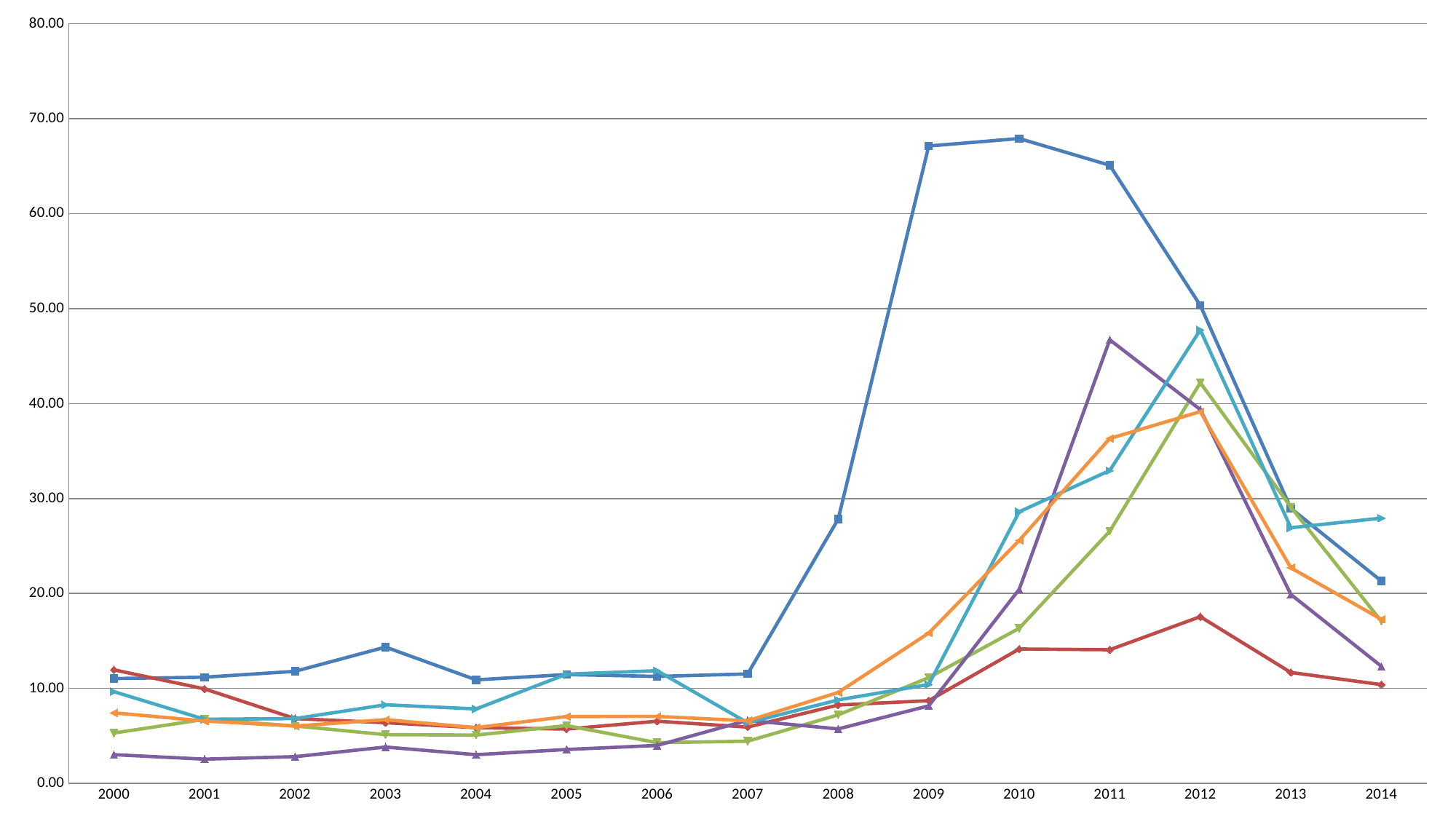
Is the value of the purple line in 2011 greater or less than 40? greater What kind of chart is shown on the slide? line chart Is the value of the red line in 2012 greater or less than 20? less In which year does the purple line reach its highest value? 2011 How many years are shown along the x axis of the chart? 15 Is the value of the blue line in 2010 greater or less than 60? greater In which year does the green line reach its highest value? 2012 Does the blue line rise or fall from 2011 to 2014? fall How many lines are plotted on the chart? 6 Which line reaches the highest value on the chart? the blue line